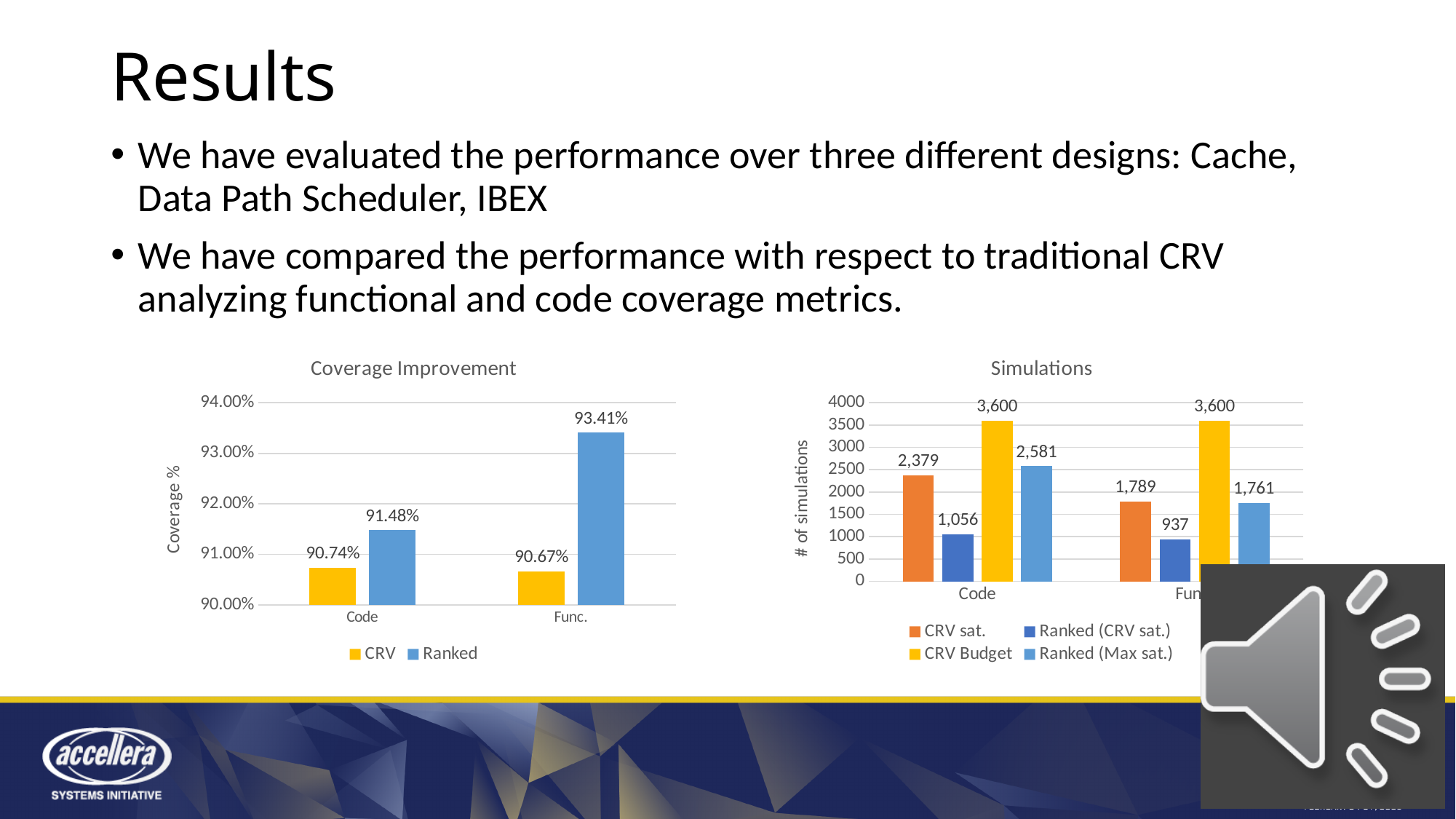
In the Simulations chart, which series has the highest value for Code? CRV Budget In the Coverage Improvement chart, what is the difference between the Ranked and CRV values for Code? 0.74% In the Coverage Improvement chart, what is the CRV value for Code? 90.74% In the Coverage Improvement chart, which category has the highest Ranked value? Func. In the Simulations chart, what is the Ranked (CRV sat.) value for Code? 1,056 In the Coverage Improvement chart, what is the Ranked value for Func.? 93.41% In the Coverage Improvement chart, how many series does the legend list? 2 In the Simulations chart, what is the CRV Budget value for Code? 3,600 In the Simulations chart, what is the difference between the Ranked (Max sat.) and CRV sat. values for Code? 202 In the Simulations chart, how many series does the legend list? 4 In the Simulations chart, what is the CRV sat. value for Code? 2,379 What kind of chart is the Coverage Improvement chart? Bar chart